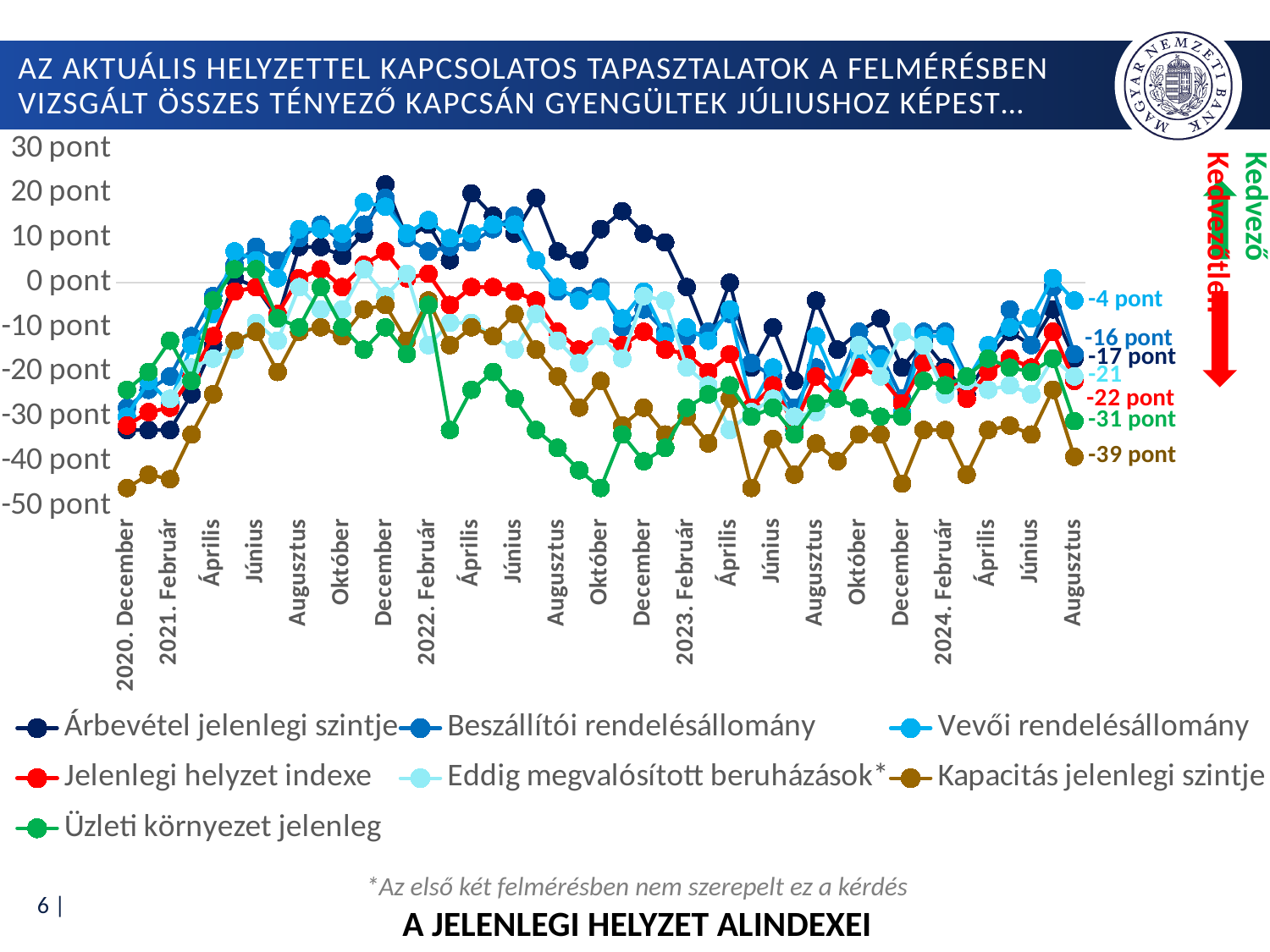
Which series has the lowest value at the end of the chart (Augusztus 2024)? Kapacitás jelenlegi szintje What is the title printed below the chart? A JELENLEGI HELYZET ALINDEXEI What is the latest (Augusztus 2024) value for Üzleti környezet jelenleg? -31 pont At the end of the chart, which is larger: Jelenlegi helyzet indexe or Üzleti környezet jelenleg? Jelenlegi helyzet indexe Is the value for Kapacitás jelenlegi szintje in 2020. December greater or less than -40 pont? less What is the latest (Augusztus 2024) value for Vevői rendelésállomány? -4 pont What is the difference between the latest values of Vevői rendelésállomány (-4 pont) and Kapacitás jelenlegi szintje (-39 pont)? 35 pont How many series does the legend list? 7 What kind of chart is shown on the slide? line chart What is the latest (Augusztus 2024) value for Beszállítói rendelésállomány? -16 pont Which series has the highest value at the end of the chart (Augusztus 2024)? Vevői rendelésállomány What is the latest (Augusztus 2024) value for Kapacitás jelenlegi szintje? -39 pont